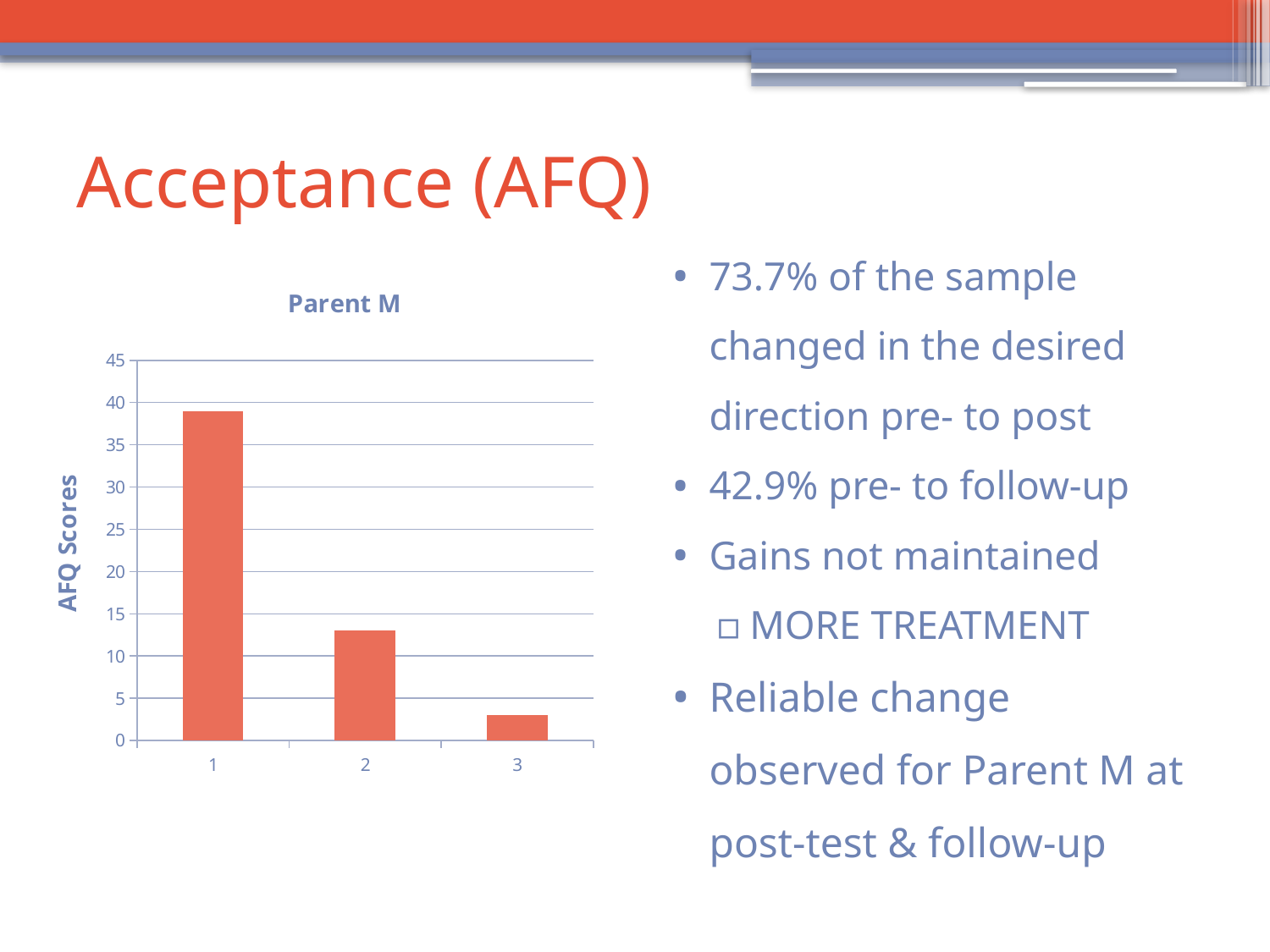
In the Parent M chart, is the value for category 2 greater or less than 10? greater In the Parent M chart, is the value for category 2 greater or less than 15? less In the Parent M chart, is the value for category 1 greater or less than 35? greater What type of chart is shown under the title "Parent M"? bar chart Do the AFQ scores rise or fall from category 1 to category 3 in the Parent M chart? fall What is the label on the vertical axis of the Parent M chart? AFQ Scores Which category has the highest AFQ score in the Parent M chart? 1 In the Parent M chart, which is larger, the value for category 1 or category 2? 1 What is the title of the chart on the slide? Parent M How many bars are plotted in the Parent M chart? 3 Which category has the lowest AFQ score in the Parent M chart? 3